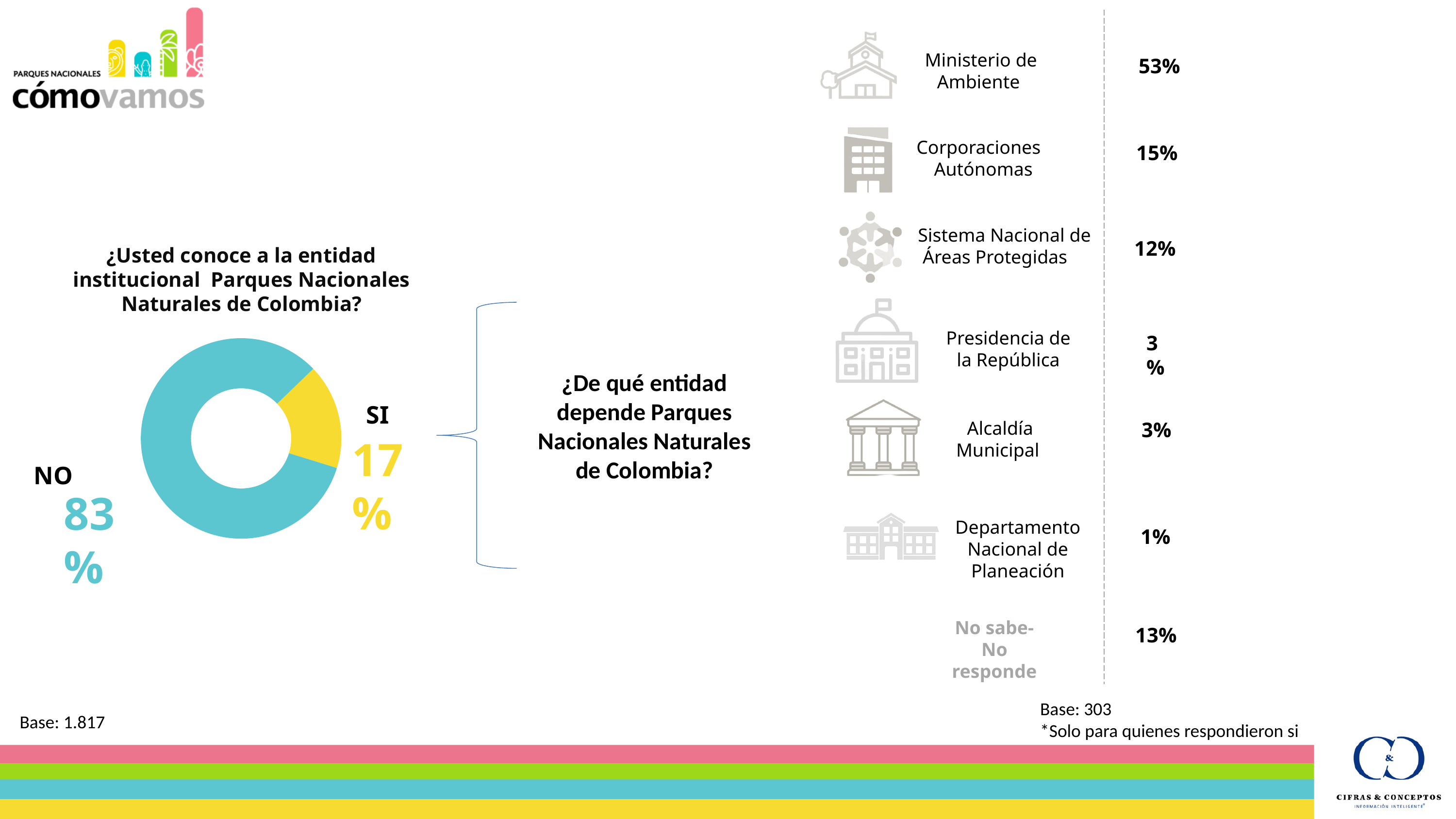
In the list '¿De qué entidad depende Parques Nacionales Naturales de Colombia?' on the right, which entity has the lowest percentage? Departamento Nacional de Planeación In the donut chart on the left, which response has the larger share, NO or SI? NO In the donut chart '¿Usted conoce a la entidad institucional Parques Nacionales Naturales de Colombia?', what percentage answered SI? 17% In the list '¿De qué entidad depende Parques Nacionales Naturales de Colombia?' on the right, what percentage is shown for Ministerio de Ambiente? 53% In the list '¿De qué entidad depende Parques Nacionales Naturales de Colombia?' on the right, which entity has the highest percentage? Ministerio de Ambiente In the donut chart '¿Usted conoce a la entidad institucional Parques Nacionales Naturales de Colombia?', what percentage answered NO? 83% How many categories does the donut chart on the left show? 2 In the donut chart on the left, what colour is the SI segment? Yellow In the list on the right, what is the difference in percentage points between Corporaciones Autónomas and Sistema Nacional de Áreas Protegidas? 3 What kind of chart is shown on the left of the slide? Donut (pie) chart In the donut chart on the left, what is the difference in percentage points between NO and SI? 66 What is the base (number of respondents) shown for the donut chart on the left? 1.817